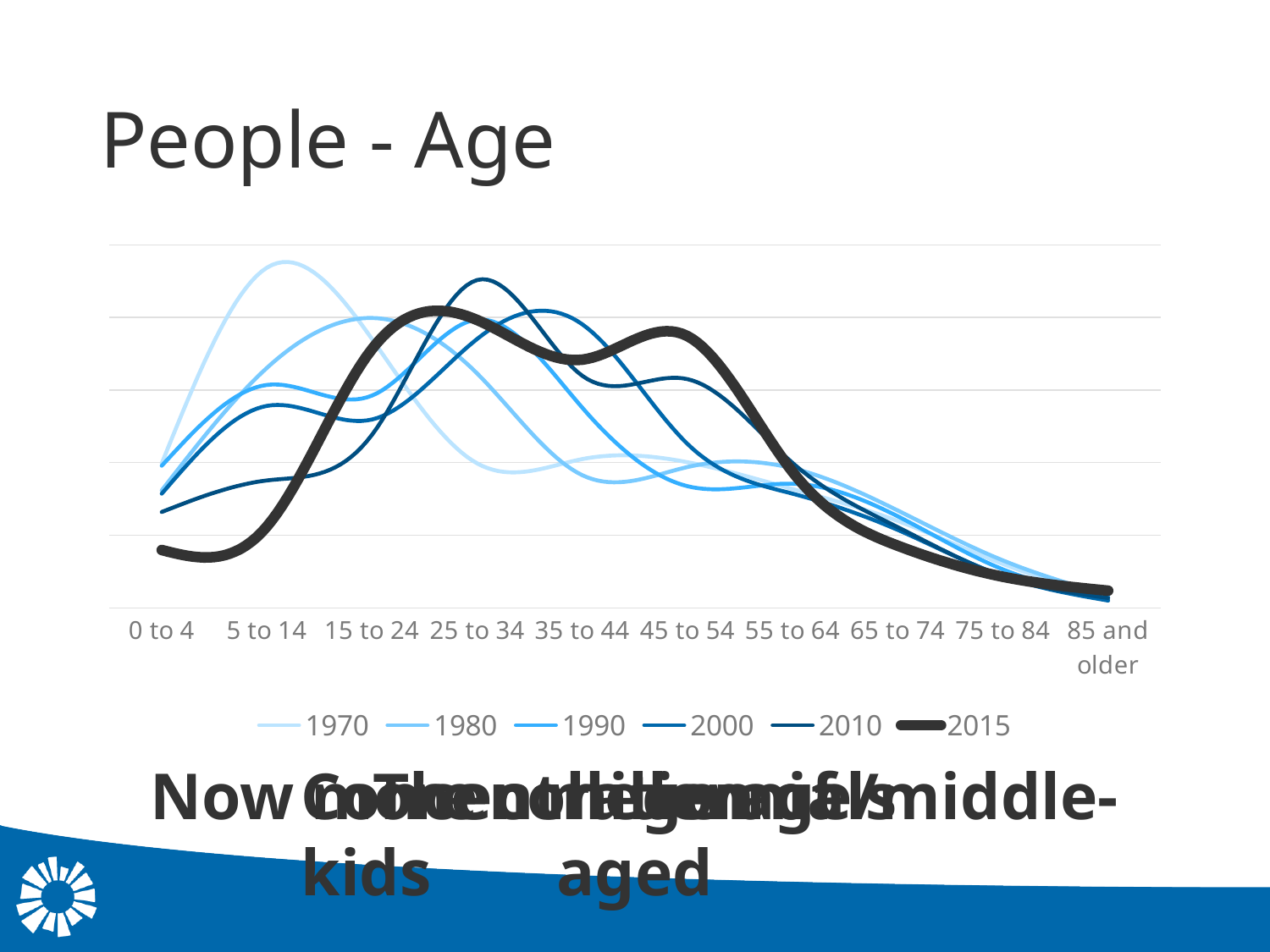
Which age category has the highest value for the 1970 series? 5 to 14 What kind of chart is shown on the slide? line chart How many series does the legend list? 6 For the 0 to 4 category, which series has the higher value: 1970 or 2015? 1970 For the 2015 series, which is larger: the value for 25 to 34 or the value for 0 to 4? 25 to 34 Do the values for the 2015 series rise or fall from 45 to 54 through 85 and older? fall Which age category has the highest value for the 2010 series? 25 to 34 Which age category has the highest value for the 1980 series? 15 to 24 How many age categories are shown on the x axis? 10 Which age category has the lowest value for the 2015 series? 85 and older Which series is drawn as the thick dark line? 2015 What is the title of the slide? People - Age